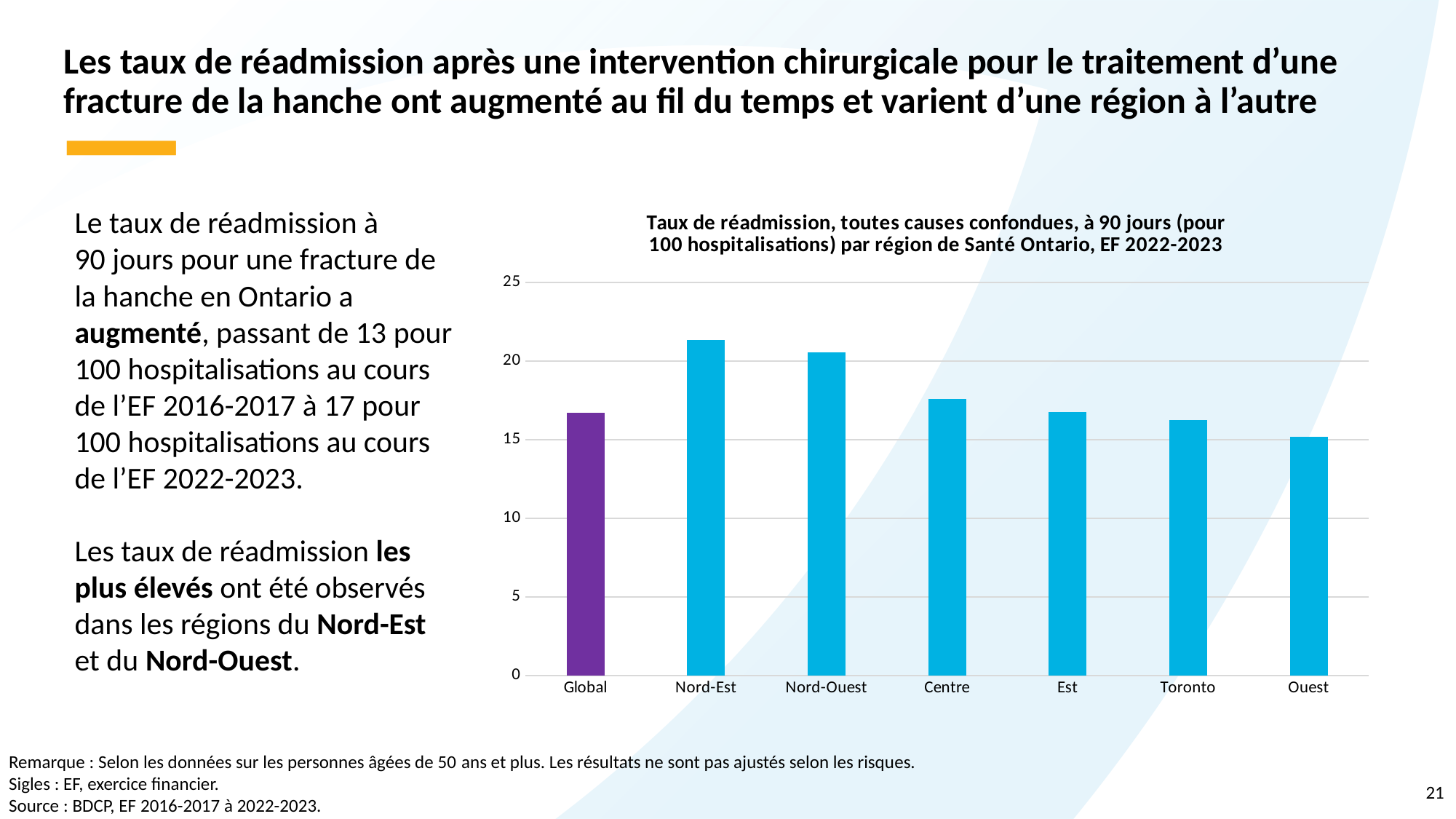
Which bar in the chart is coloured purple rather than blue? Global What is the highest value shown on the y axis of the chart? 25 Which region has the lowest readmission rate in the chart? Ouest Is the readmission rate for Ouest greater or less than 20? less How many regions (categories) are shown on the x axis of the chart? 7 Which has a higher readmission rate, Nord-Ouest or Centre? Nord-Ouest What kind of chart is shown on the slide? bar chart Is the readmission rate for Centre greater or less than 20? less Is the readmission rate for Nord-Est greater or less than 20? greater Which has a higher readmission rate, Centre or Toronto? Centre Which region has the highest readmission rate in the chart? Nord-Est